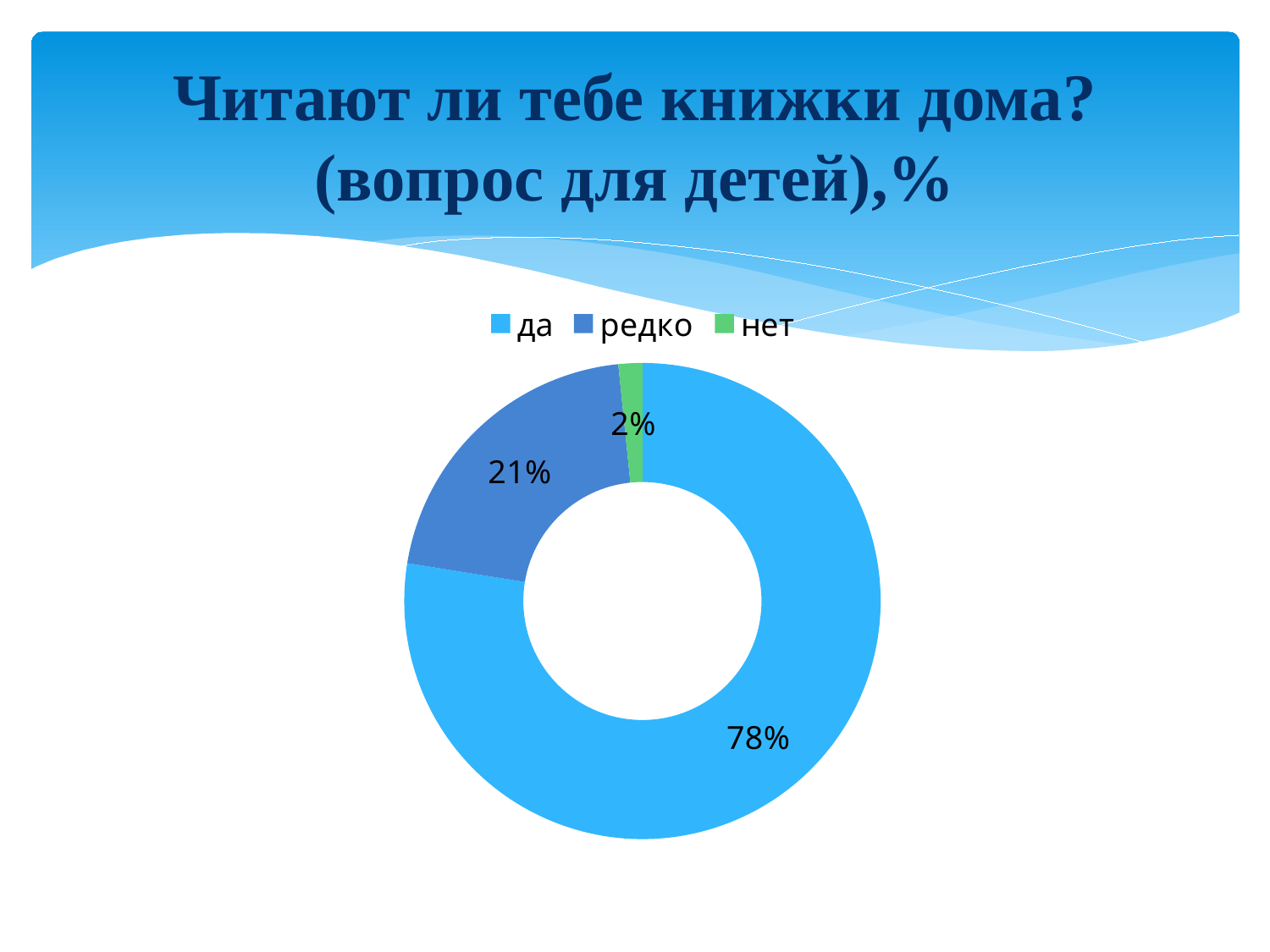
Which answer has the largest share of the chart? да What colour is the "нет" segment? green What percentage of children answered "да"? 78% What is the difference in percentage points between "да" and "редко"? 57 What percentage of children answered "редко"? 21% Which answer has the smallest share of the chart? нет What kind of chart is shown on the slide? doughnut chart Which is larger, the share for "редко" or the share for "нет"? редко What is the difference in percentage points between "редко" and "нет"? 19 What is the title of the slide? Читают ли тебе книжки дома? (вопрос для детей),% What percentage of children answered "нет"? 2% How many categories does the chart show? 3